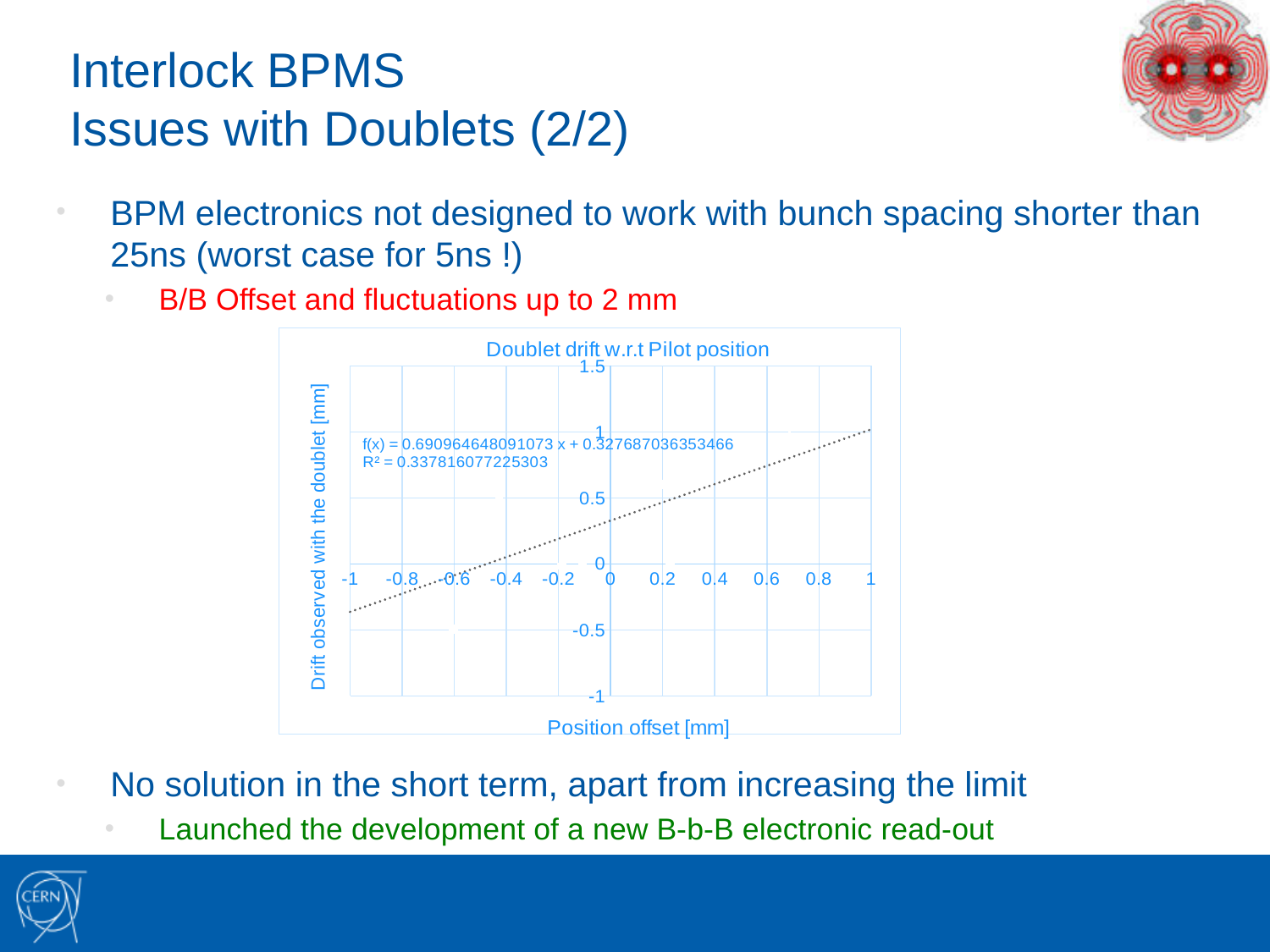
What is the slope of the fitted line f(x) printed on the chart? 0.690964648091073 What is the title of the chart? Doublet drift w.r.t Pilot position What is the intercept of the fitted line f(x) printed on the chart? 0.327687036353466 Is the value of the fitted trend line at a position offset of -1 mm greater or less than 0? less Is the value of the fitted trend line at a position offset of 0 mm greater or less than 0.5? less What is the R² value printed on the chart? 0.337816077225303 Does the fitted trend line rise or fall as the position offset increases from -1 to 1? rises What kind of chart is shown on the slide? scatter chart with a fitted trend line What is the label of the vertical axis of the chart? Drift observed with the doublet [mm] Is the value of the fitted trend line at a position offset of 1 mm greater or less than 0.5? greater